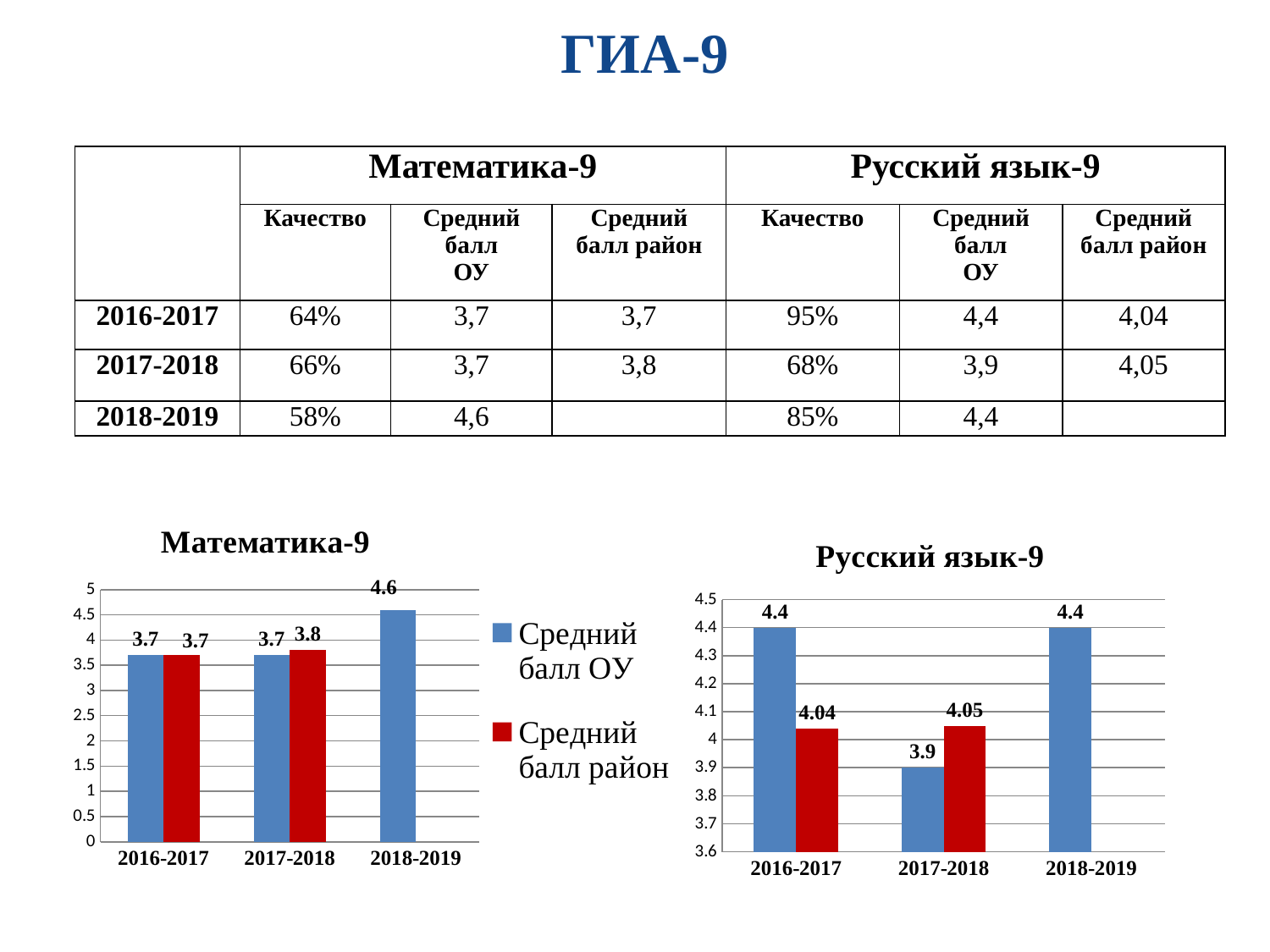
How many year categories are shown on the x axis of the Русский язык-9 chart? 3 In the Русский язык-9 chart, what is the value of the blue bar for 2017-2018? 3.9 How many series does the legend of the Математика-9 chart list? 2 In the Математика-9 chart, what is the value of Средний балл район for 2017-2018? 3.8 In the Русский язык-9 chart, which year has the lowest blue bar? 2017-2018 In the Математика-9 chart, what is the difference between Средний балл ОУ in 2018-2019 and in 2017-2018? 0.9 In the Математика-9 chart, what is the value of Средний балл ОУ for 2018-2019? 4.6 In the Математика-9 chart, which year has the highest Средний балл ОУ? 2018-2019 What type of chart is the Математика-9 chart? bar chart In the Русский язык-9 chart, which is larger for 2017-2018: the blue bar or the red bar? the red bar In the Русский язык-9 chart, what is the value of the red bar for 2016-2017? 4.04 In the Русский язык-9 chart, what is the difference between the red bars for 2017-2018 and 2016-2017? 0.01